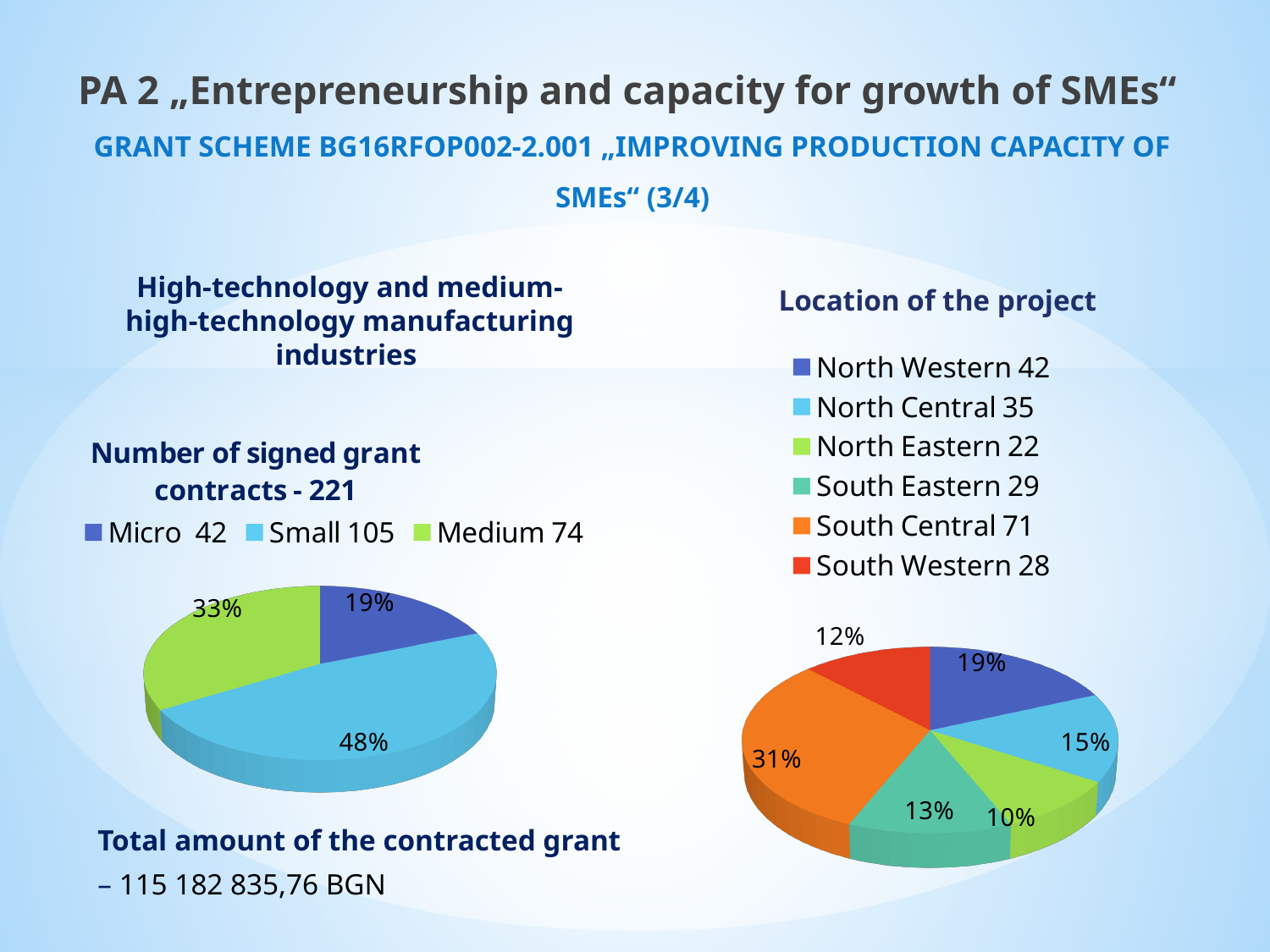
In the "Number of signed grant contracts - 221" chart, how many categories does the legend list? 3 In the "Number of signed grant contracts - 221" chart, which category has the largest slice? Small In the "Location of the project" chart, what percentage share does North Eastern have? 10% In the "Number of signed grant contracts - 221" chart, what percentage share does Medium have? 33% In the "Location of the project" chart, how many regions does the legend list? 6 In the "Location of the project" chart, which region has the smallest slice? North Eastern What kind of chart is the "Number of signed grant contracts - 221" chart? pie chart In the "Location of the project" chart, what value does the legend show for North Central? 35 In the "Number of signed grant contracts - 221" chart, what percentage share does Small have? 48% In the "Number of signed grant contracts - 221" chart, what is the difference between the Small and Micro counts shown in the legend? 63 In the "Location of the project" chart, which is larger: North Western or South Eastern? North Western